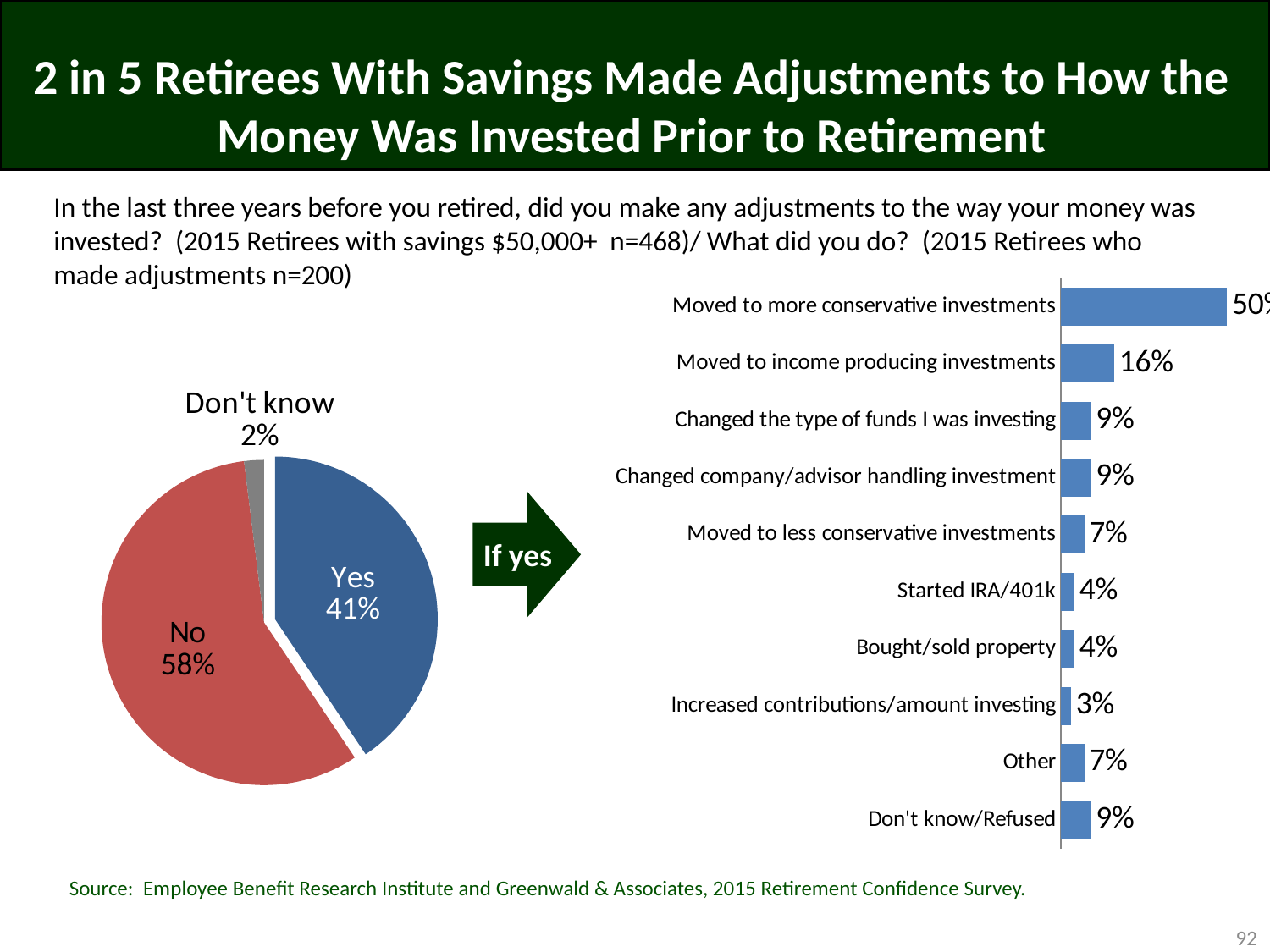
In the pie chart on the left, what share of retirees answered Yes? 41% In the bar chart on the right, what is the value for Increased contributions/amount investing? 3% In the bar chart on the right, how many categories are shown? 10 In the pie chart on the left, what share of retirees answered Don't know? 2% In the bar chart on the right, which adjustment has the highest value? Moved to more conservative investments In the pie chart on the left, what share of retirees answered No? 58% What type of chart is on the right side of the slide? Bar chart In the pie chart on the left, how many slices are there? 3 In the bar chart on the right, which adjustment has the lowest value? Increased contributions/amount investing In the pie chart on the left, which response has the largest slice? No In the bar chart on the right, what is the difference between Moved to income producing investments and Moved to less conservative investments? 9% In the bar chart on the right, what is the value for Moved to income producing investments? 16%